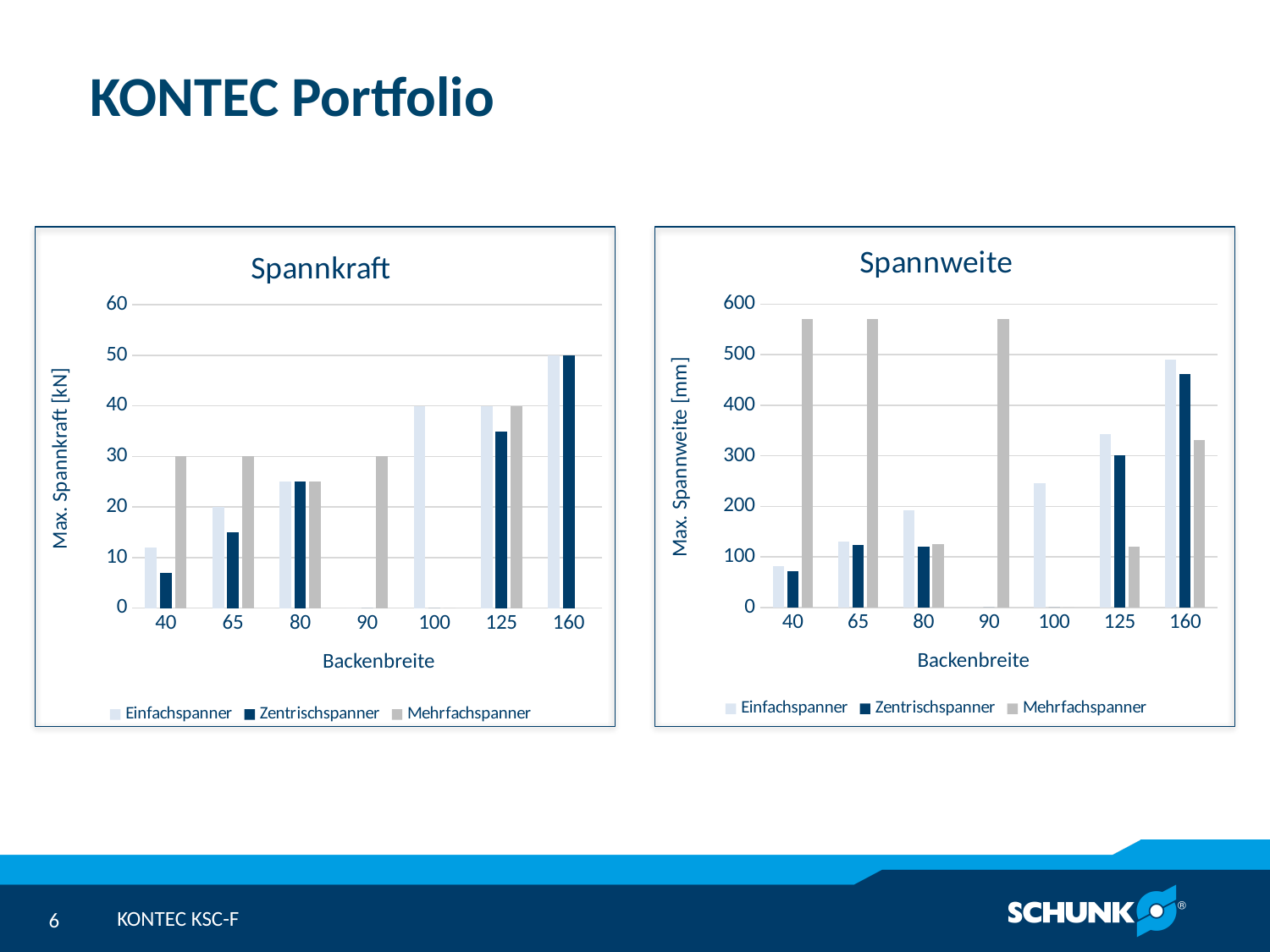
What is the y-axis label of the Spannweite chart? Max. Spannweite [mm] In the Spannweite chart, is the Zentrischspanner value at Backenbreite 40 greater or less than 100? less In the Spannkraft chart, what is the Mehrfachspanner value at Backenbreite 40? 30 How many Backenbreite categories are shown on the x axis of the Spannkraft chart? 7 In the Spannkraft chart, what is the Einfachspanner value at Backenbreite 160? 50 What type of chart is the Spannkraft chart on the left? bar chart How many series does the legend of the Spannweite chart list? 3 In the Spannweite chart, is the Mehrfachspanner value at Backenbreite 90 greater or less than 500? greater In the Spannweite chart, at Backenbreite 160, which is larger: Einfachspanner or Mehrfachspanner? Einfachspanner In the Spannkraft chart, at Backenbreite 40, which is larger: Zentrischspanner or Mehrfachspanner? Mehrfachspanner In the Spannkraft chart, what is the Einfachspanner value at Backenbreite 100? 40 What is the x-axis title of the Spannkraft chart? Backenbreite